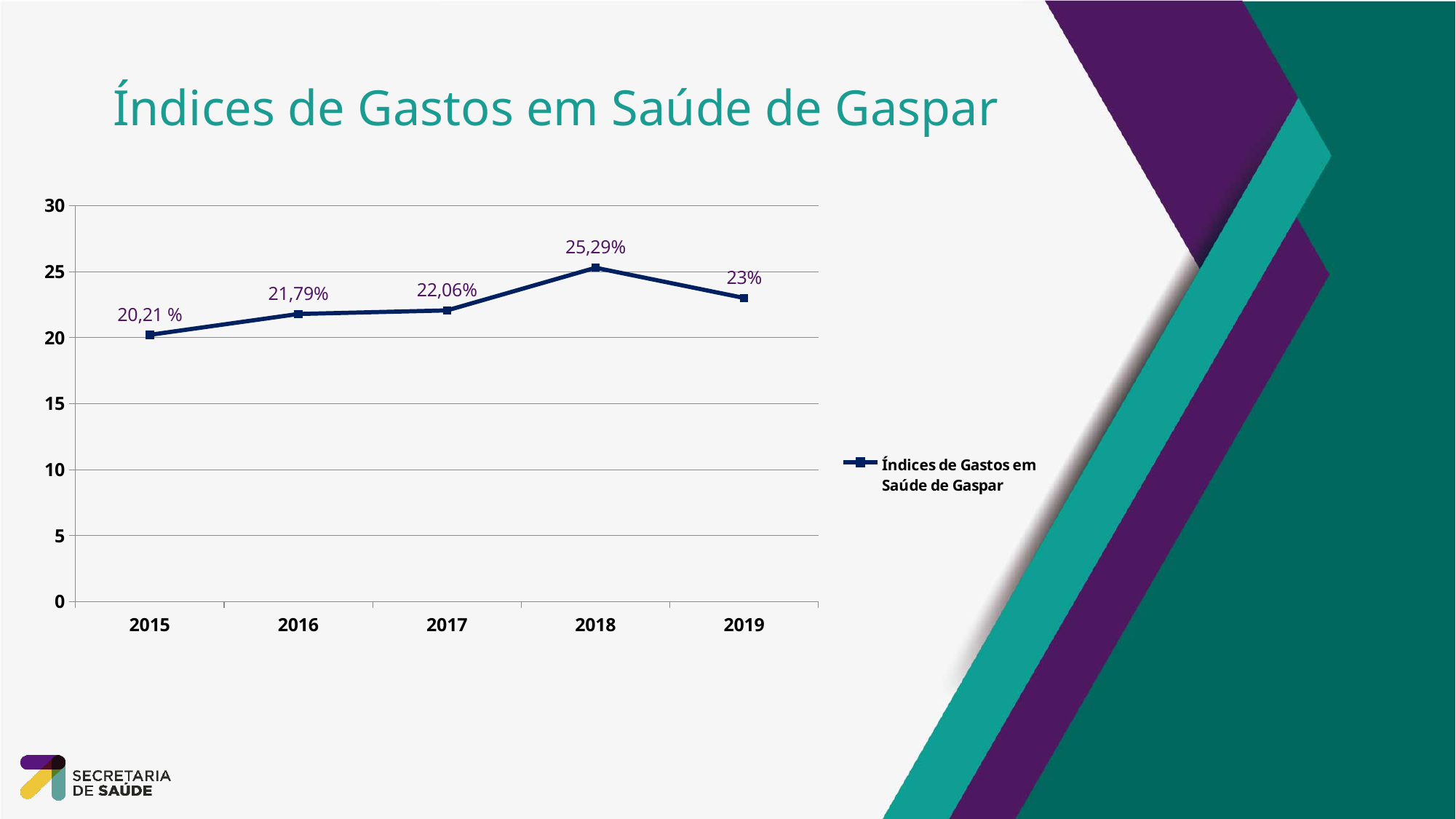
What is the value for 2017? 22,06% What is the difference between the values for 2018 and 2019? 2,29% Does the value rise or fall from 2015 to 2018? rise What is the value for 2018? 25,29% What is the value for 2019? 23% Which is larger, the value for 2016 or the value for 2017? 2017 Is the value for 2018 greater or less than 25? greater Which year has the lowest value? 2015 What is the value for 2015? 20,21 % Which year has the highest value? 2018 How many years are plotted on the x axis? 5 What kind of chart is shown? line chart